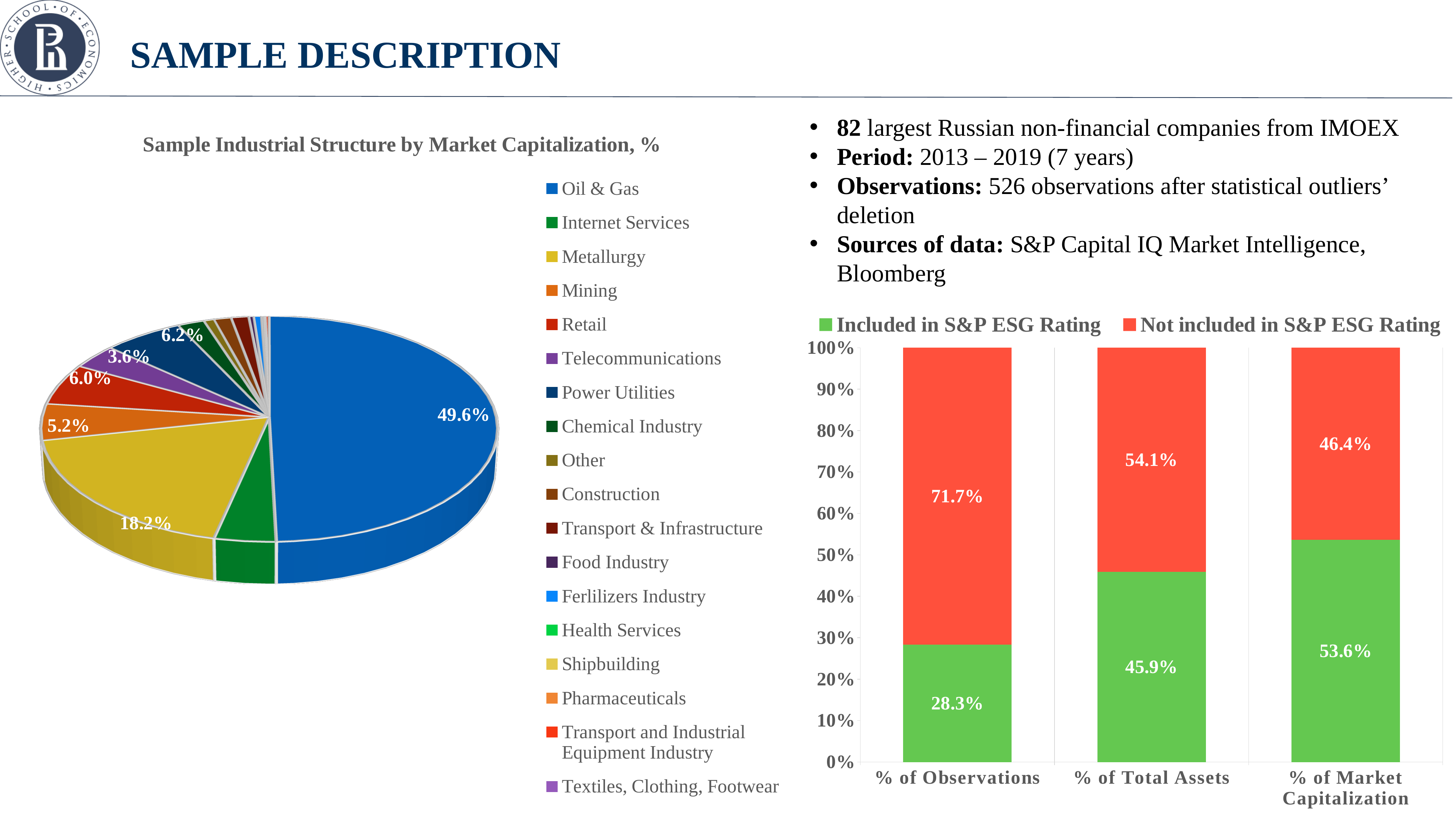
In the pie chart 'Sample Industrial Structure by Market Capitalization, %', which industry has the largest share? Oil & Gas In the stacked bar chart on the right, what is the value for 'Included in S&P ESG Rating' in the '% of Market Capitalization' category? 53.6% In the stacked bar chart on the right, how many series does the legend list? 2 What kind of chart is shown on the right side of the slide? Stacked bar chart In the stacked bar chart on the right, what is the value for 'Included in S&P ESG Rating' in the '% of Observations' category? 28.3% In the pie chart 'Sample Industrial Structure by Market Capitalization, %', what is the difference between the Oil & Gas share and the Metallurgy share? 31.4% In the pie chart 'Sample Industrial Structure by Market Capitalization, %', what share does Oil & Gas have? 49.6% In the pie chart 'Sample Industrial Structure by Market Capitalization, %', what share does Metallurgy have? 18.2% In the stacked bar chart on the right, in which category is the 'Included in S&P ESG Rating' share the highest? % of Market Capitalization In the stacked bar chart on the right, what is the value for 'Not included in S&P ESG Rating' in the '% of Total Assets' category? 54.1% In the pie chart 'Sample Industrial Structure by Market Capitalization, %', how many industries does the legend list? 18 In the stacked bar chart on the right, which is larger in the '% of Total Assets' category: 'Included in S&P ESG Rating' or 'Not included in S&P ESG Rating'? Not included in S&P ESG Rating